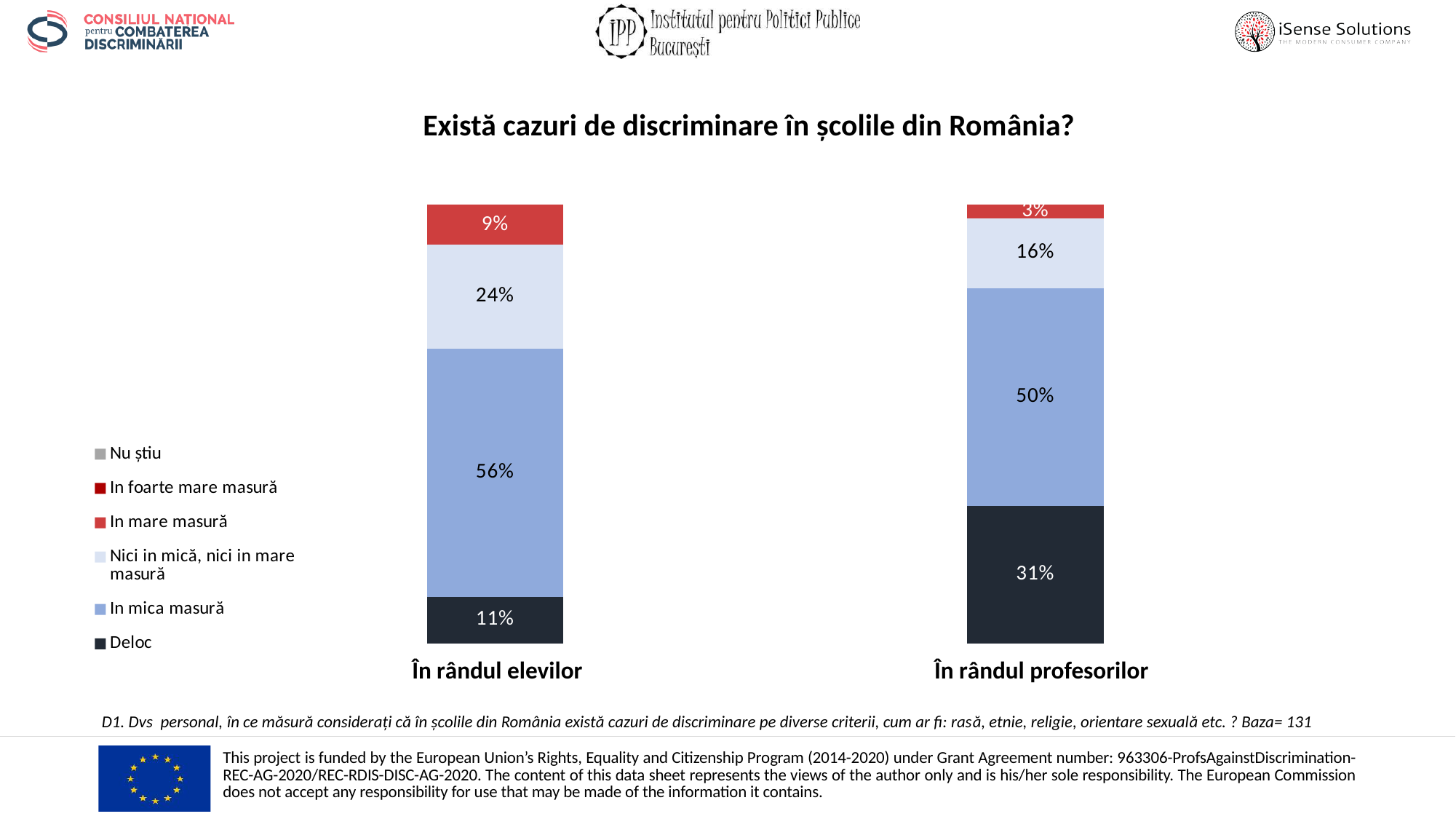
Which bar has the larger 'In mica masură' value, 'În rândul elevilor' or 'În rândul profesorilor'? În rândul elevilor What is the value of the top red segment in the 'În rândul profesorilor' bar? 3% What is the title of the chart? Există cazuri de discriminare în școlile din România? What is the value for 'Nici in mică, nici in mare masură' in the 'În rândul elevilor' bar? 24% What is the value for 'Deloc' in the 'În rândul profesorilor' bar? 31% How many bars (categories) are plotted in the chart? 2 What kind of chart is shown on the slide? Stacked bar chart What is the value for 'In mica masură' in the 'În rândul elevilor' bar? 56% Which segment is the smallest in the 'În rândul elevilor' bar? In mare masură (9%) What is the difference between the 'Deloc' values for 'În rândul profesorilor' and 'În rândul elevilor'? 20% How many series does the legend list? 6 Which segment is the largest in the 'În rândul profesorilor' bar? In mica masură